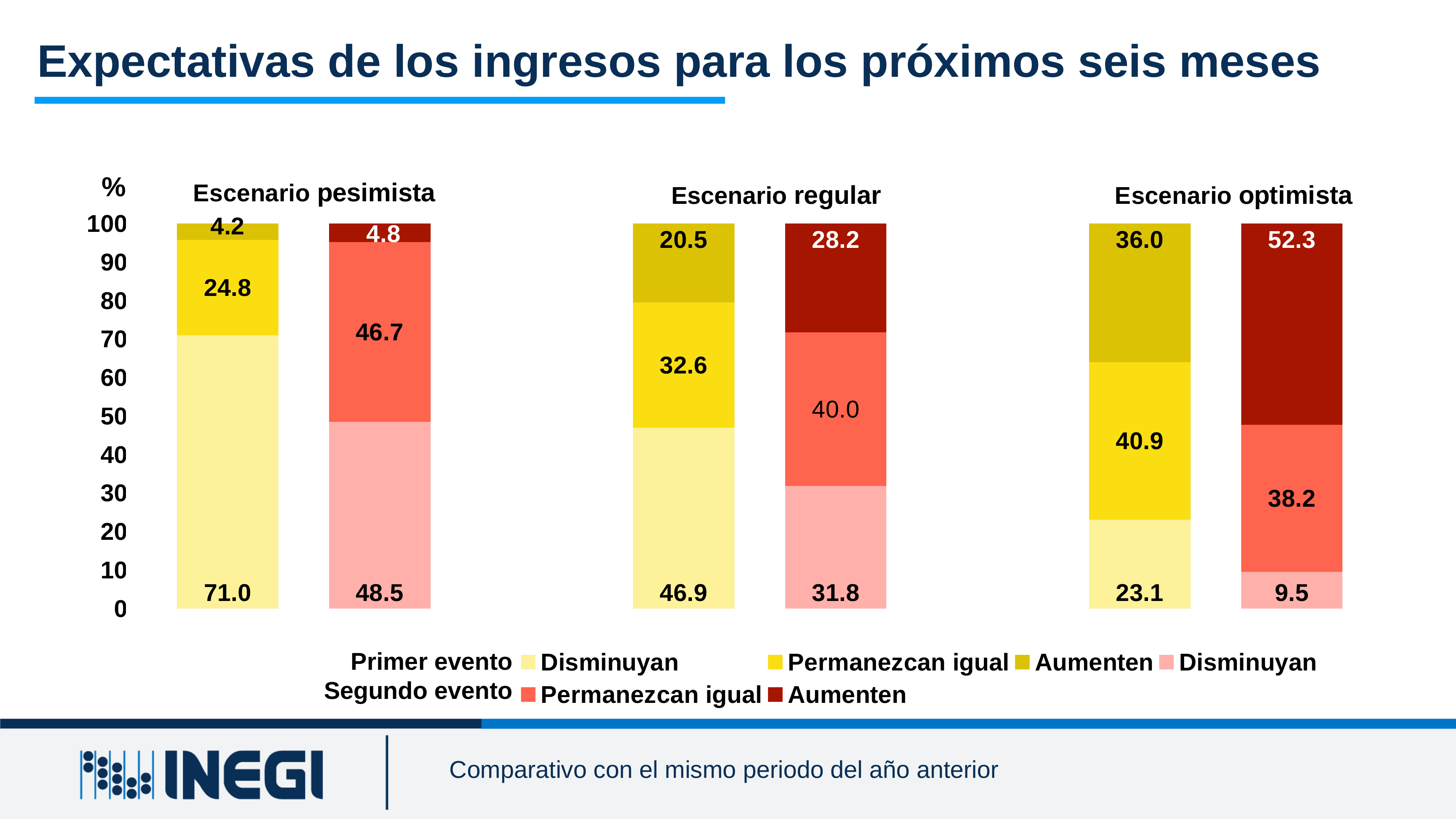
Across the three scenarios, which scenario has the highest Aumenten value in the Primer evento bar? Escenario optimista In the Escenario pesimista, what is the value for Disminuyan in the Primer evento bar? 71.0 In the Escenario regular, what is the value for Permanezcan igual in the Segundo evento bar? 40.0 How many scenarios are shown on the x axis of the chart? 3 In the Escenario optimista, what is the value for Disminuyan in the Segundo evento bar? 9.5 In the Escenario regular, what is the difference between the Aumenten values of the Segundo evento bar (28.2) and the Primer evento bar (20.5)? 7.7 Across the three scenarios, which scenario has the lowest Disminuyan value in the Segundo evento bar? Escenario optimista How many series does the legend list in total? 6 What kind of chart is shown on the slide? Stacked bar chart What is the total of the Primer evento stacked bar in the Escenario optimista (23.1 + 40.9 + 36.0)? 100.0 In the Escenario optimista, what is the value for Aumenten in the Segundo evento bar? 52.3 In the Escenario pesimista, which is larger: Permanezcan igual in the Primer evento bar or Permanezcan igual in the Segundo evento bar? Segundo evento